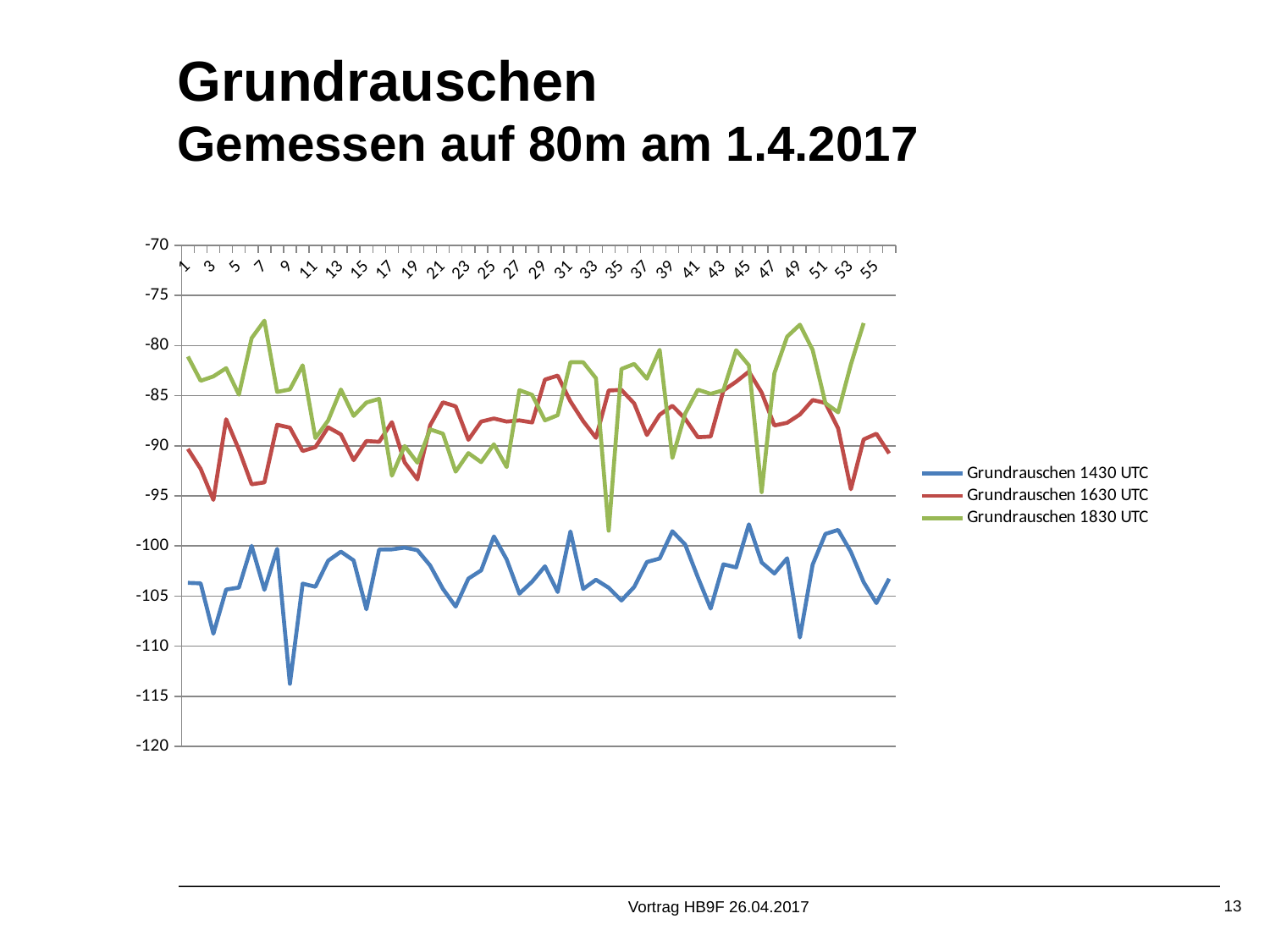
Is the value for Grundrauschen 1630 UTC at point 3 greater or less than -90? less Is the value for Grundrauschen 1430 UTC at point 49 greater or less than -105? less How many series does the legend list? 3 What is the lowest value shown on the vertical axis? -120 Is the value for Grundrauschen 1630 UTC at point 45 greater or less than -85? greater Which series has the lowest values across the whole chart? Grundrauschen 1430 UTC What kind of chart is shown on the slide? line chart At point 1, which series has the higher value, Grundrauschen 1430 UTC or Grundrauschen 1830 UTC? Grundrauschen 1830 UTC What are the three series named in the legend? Grundrauschen 1430 UTC, Grundrauschen 1630 UTC, Grundrauschen 1830 UTC